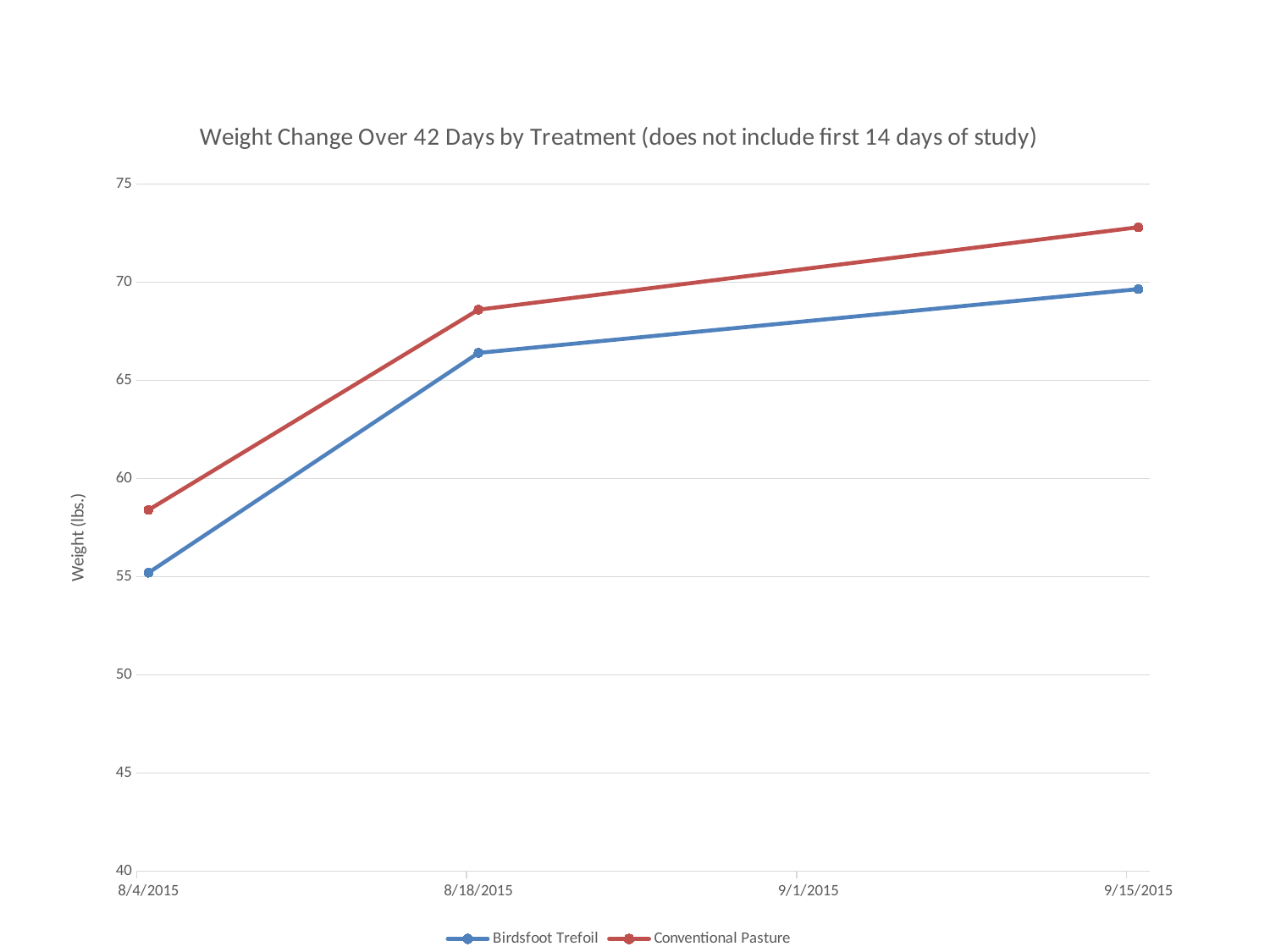
How many series does the legend list? 2 Is the value for Conventional Pasture on 9/15/2015 greater or less than 70? greater What kind of chart is shown on the slide? line chart Do the Conventional Pasture values rise or fall from 8/4/2015 to 9/15/2015? rise What is the label on the vertical axis? Weight (lbs.) How many data points are plotted for the Birdsfoot Trefoil series? 3 On which date is the Conventional Pasture value lowest? 8/4/2015 On 8/4/2015, which series has the higher value, Birdsfoot Trefoil or Conventional Pasture? Conventional Pasture Is the value for Birdsfoot Trefoil on 8/4/2015 greater or less than 60? less Is the value for Conventional Pasture on 8/18/2015 greater or less than 65? greater On which date is the Birdsfoot Trefoil value highest? 9/15/2015